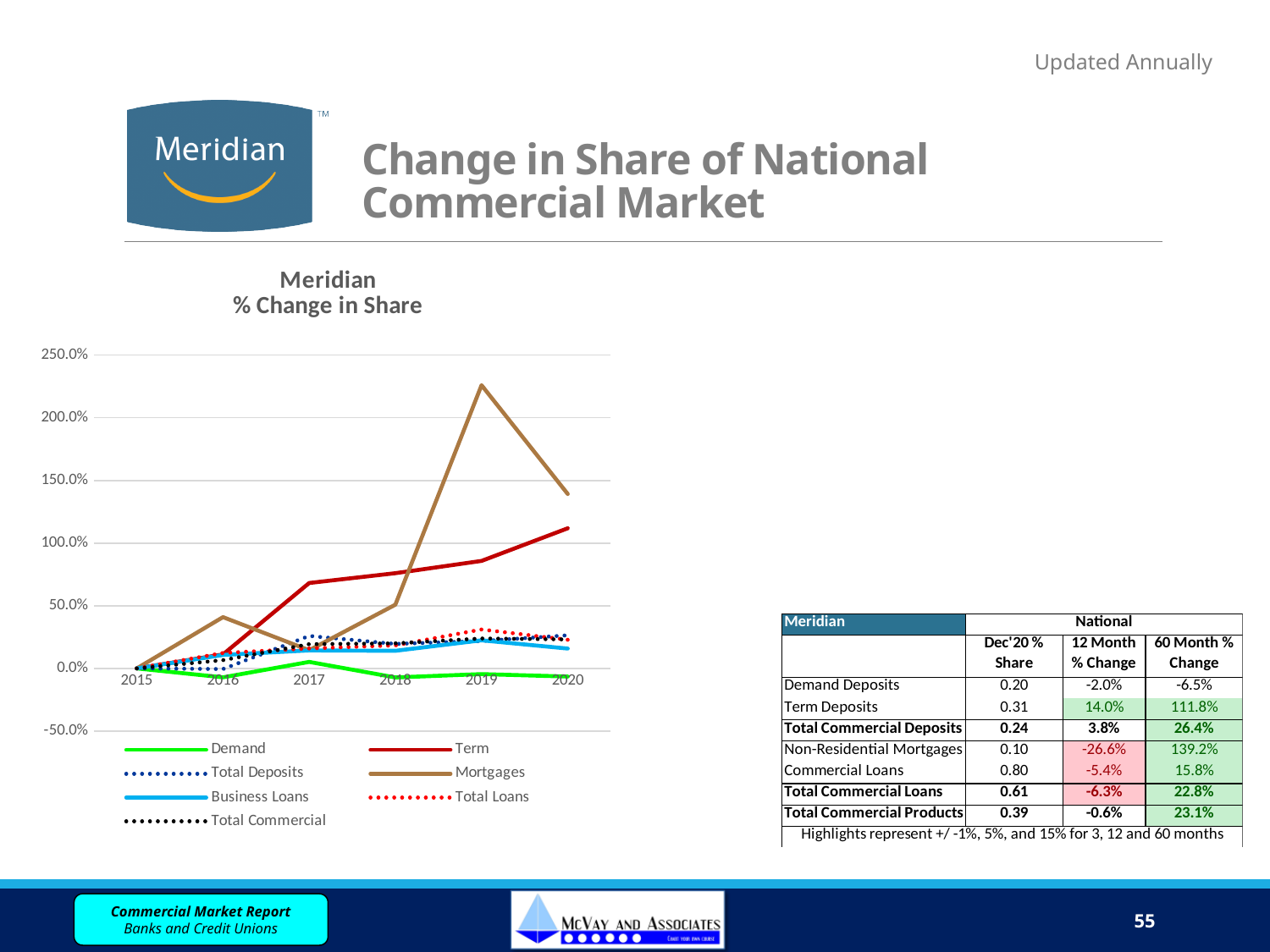
Is the value for Term in 2020 greater or less than 100.0%? greater Is the value for Mortgages in 2019 greater or less than 200.0%? greater Is the value for Demand in 2020 greater or less than 50.0%? less Which series has the lowest value in 2020? Demand Does the Mortgages series rise or fall from 2019 to 2020? fall How many series does the legend of the chart list? 7 Which series has the highest value in 2019? Mortgages What is the title of the chart? Meridian % Change in Share Does the Term series rise or fall from 2015 to 2020? rise In 2020, which is larger: the value for Mortgages or the value for Term? Mortgages How many years are shown along the x axis of the chart? 6 What kind of chart is shown on the slide? line chart